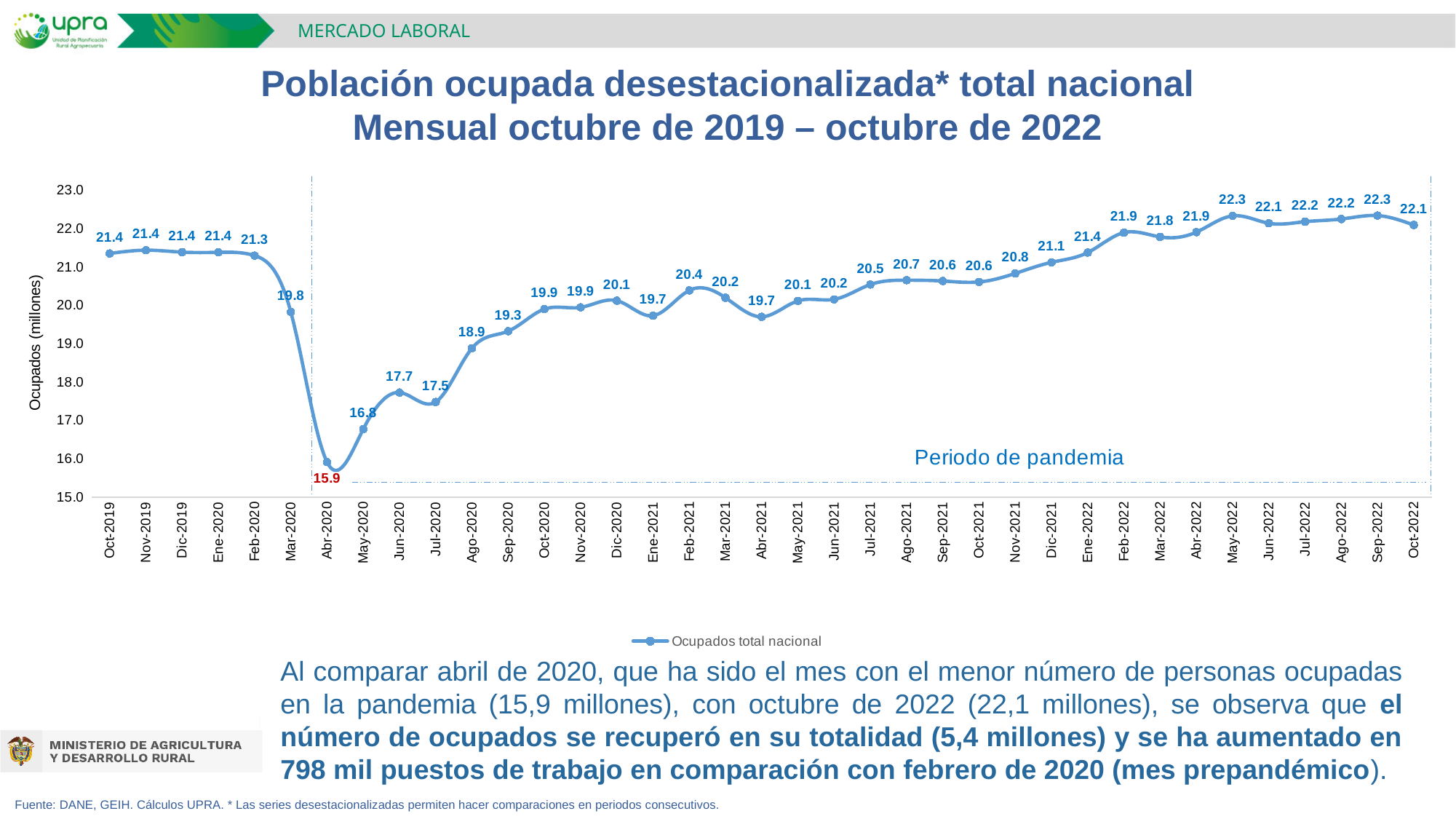
Which month has the lowest number of occupied persons? Abr-2020 What is the value for Oct-2022? 22.1 How many series does the legend list? 1 Is the value for May-2020 greater or less than 17.0? less What is the value for Mar-2020? 19.8 Which is larger, the value for Jun-2020 or the value for Jul-2020? Jun-2020 What is the value for Abr-2020? 15.9 What is the name of the series shown in the legend? Ocupados total nacional How many monthly data points are plotted on the chart? 37 What kind of chart is shown on the slide? Line chart What is the difference between the values for Oct-2022 and Feb-2020? 0.8 What is the difference between the values for Oct-2022 and Abr-2020? 6.2